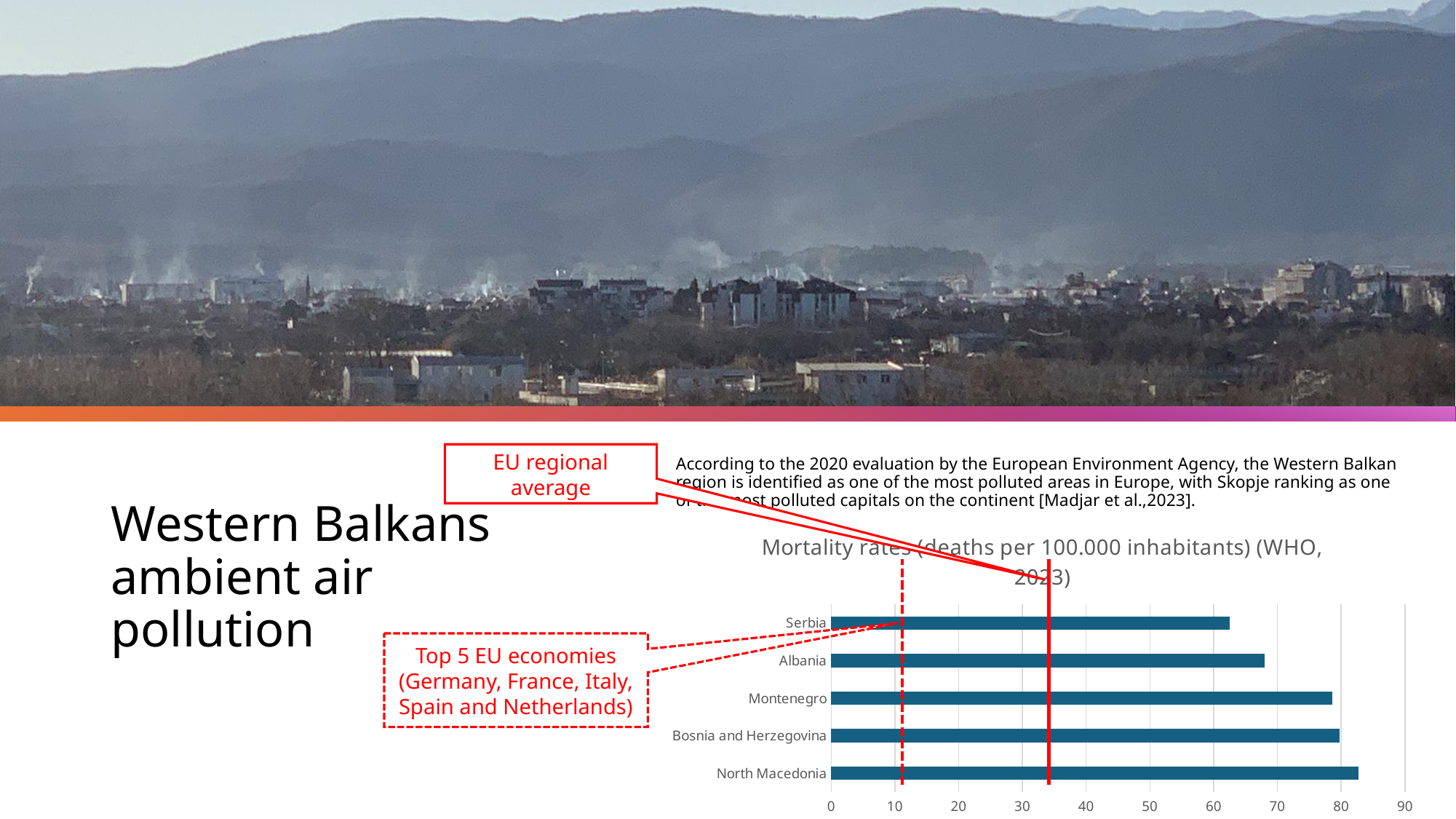
Is the value for Albania greater or less than 70? less Which country has the lowest mortality rate in the chart? Serbia Which has a higher mortality rate, Serbia or Albania? Albania What is the title of the chart? Mortality rates (deaths per 100.000 inhabitants) (WHO, 2023) Is the value for Montenegro greater or less than 70? greater Is the value for North Macedonia greater or less than 80? greater Which has a higher mortality rate, Albania or Montenegro? Montenegro What kind of chart is shown on the slide? bar chart How many countries are shown in the chart? 5 Which country has the highest mortality rate in the chart? North Macedonia What does the solid red vertical line on the chart represent? EU regional average